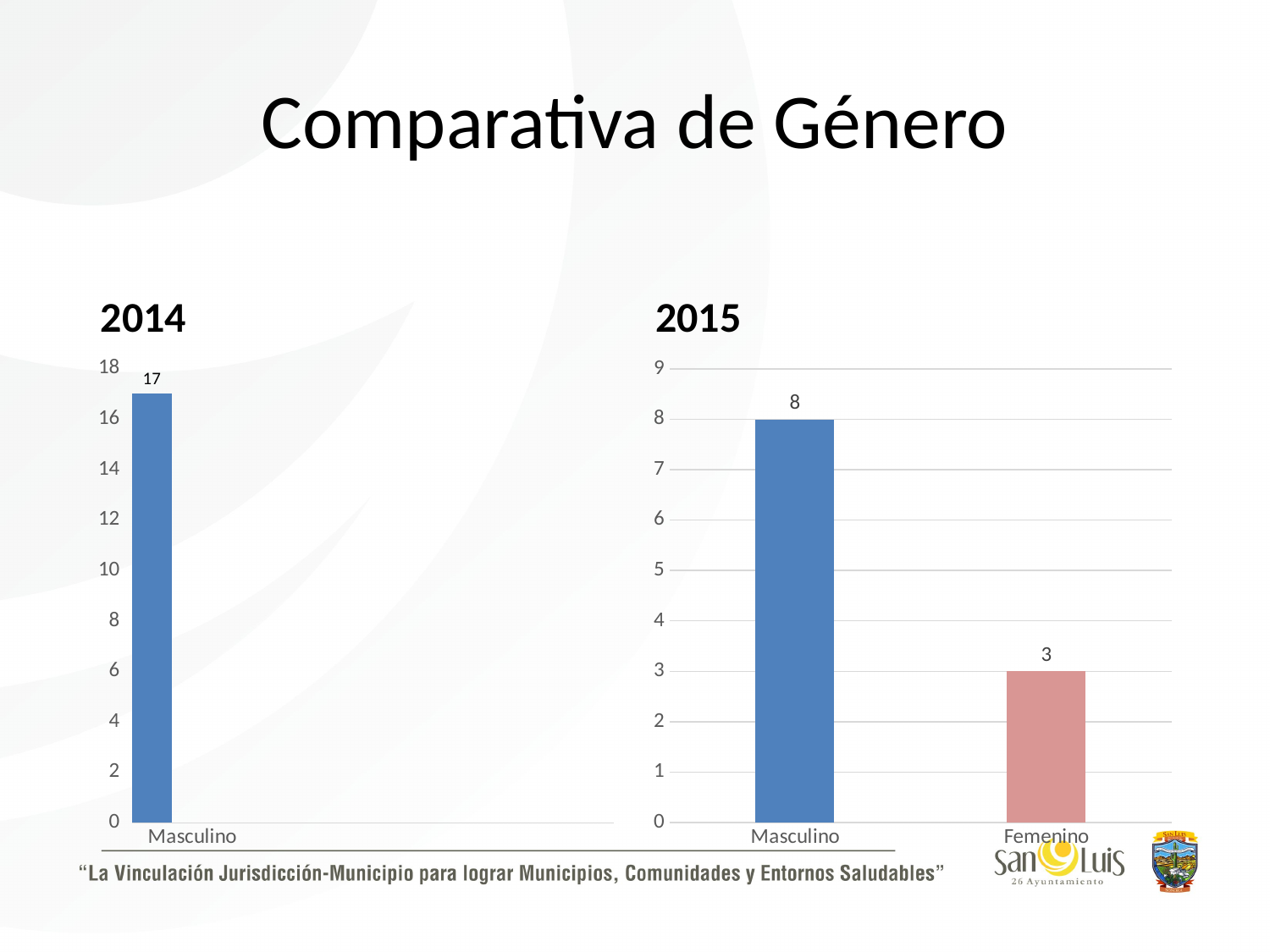
In the 2015 chart, what is the value for Femenino? 3 In the 2015 chart, which category has the lowest value? Femenino What kind of chart is the 2014 chart? Bar chart What is the title of the slide containing the two charts? Comparativa de Género How many categories are shown in the 2015 chart? 2 In the 2015 chart, what is the value for Masculino? 8 In the 2015 chart, which is larger, Masculino or Femenino? Masculino In the 2014 chart, what is the value for Masculino? 17 In the 2015 chart, which category has the highest value? Masculino What is the difference between the Masculino value in the 2014 chart and the Masculino value in the 2015 chart? 9 How many categories are shown in the 2014 chart? 1 In the 2015 chart, what is the difference between the Masculino and Femenino values? 5